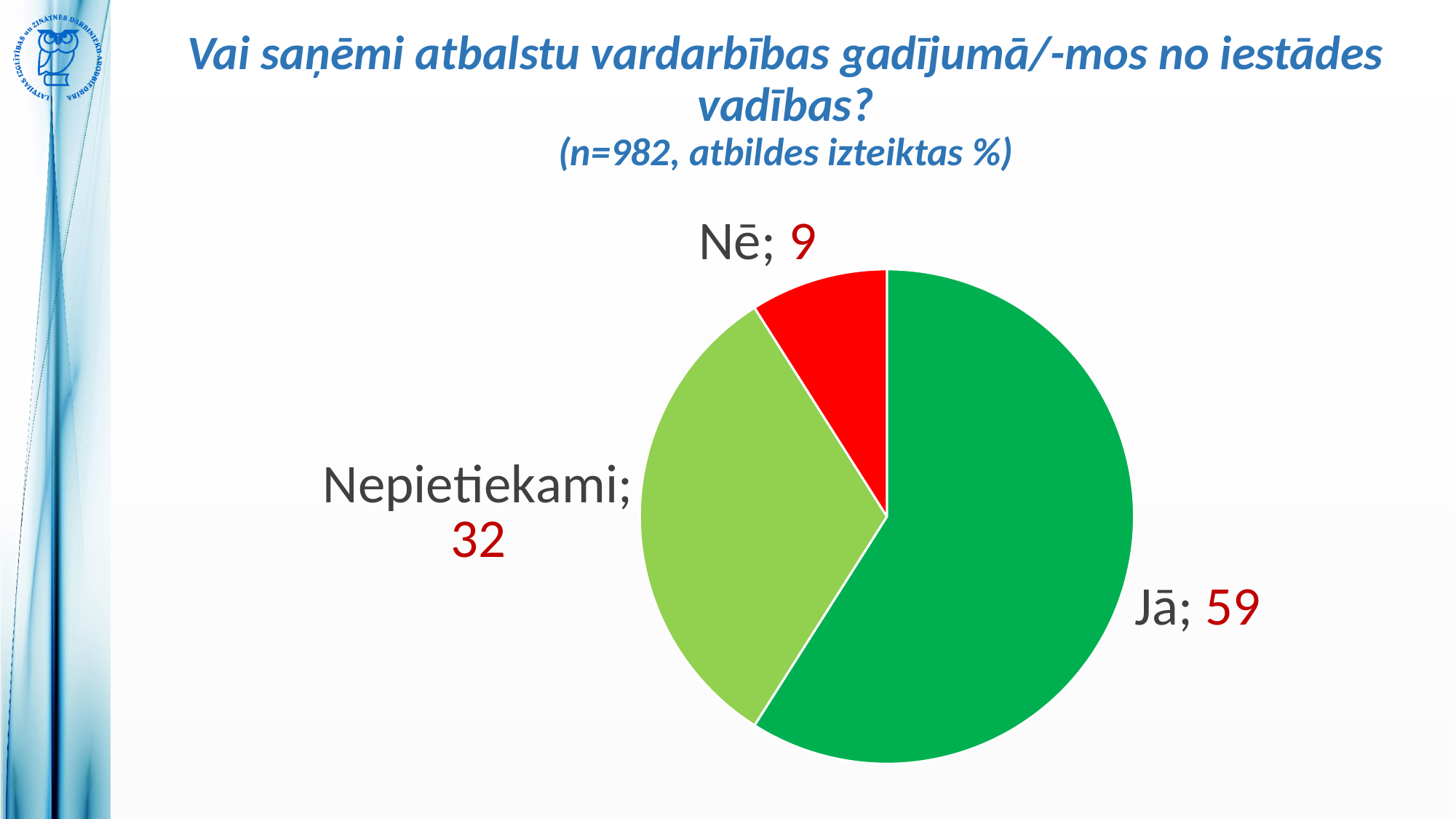
What type of chart is shown on the slide? pie chart How many slices does the pie chart have? 3 Which category has the smallest slice? Nē Which category has the largest slice? Jā What is the value for "Nē"? 9 What is the sample size (n) stated in the chart title? 982 What colour is the "Nē" slice? red What is the value for "Jā"? 59 What is the difference between the values for "Jā" and "Nepietiekami"? 27 What is the difference between the values for "Nepietiekami" and "Nē"? 23 What is the value for "Nepietiekami"? 32 Which is larger, the value for "Nepietiekami" or the value for "Nē"? Nepietiekami